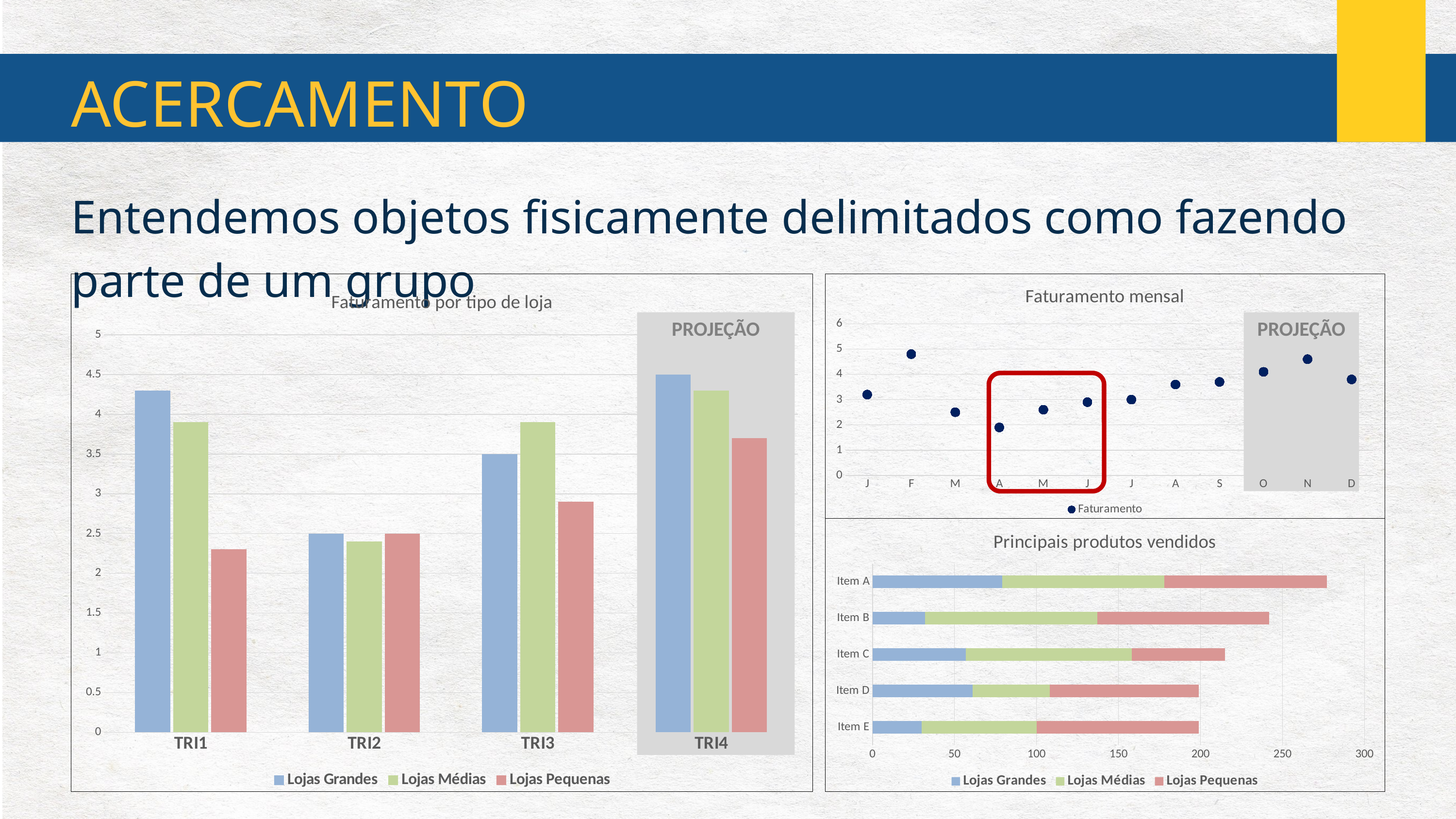
In the 'Principais produtos vendidos' chart, is the total for Item E greater or less than 250? less In the 'Faturamento mensal' chart, how many data points are plotted? 12 In the 'Faturamento mensal' chart, is the value for F greater or less than 4? greater In the 'Faturamento por tipo de loja' chart, which quarter has the lowest value for Lojas Grandes? TRI2 In the 'Faturamento por tipo de loja' chart, how many series does the legend list? 3 What kind of chart is 'Faturamento por tipo de loja'? bar chart In the 'Faturamento por tipo de loja' chart, is the value for Lojas Grandes in TRI1 greater or less than 4? greater In the 'Principais produtos vendidos' chart, which item has the longest total bar? Item A In the 'Faturamento mensal' chart, which month has the lowest value? A (April) In the 'Faturamento por tipo de loja' chart, how many quarters are shown on the x axis? 4 In the 'Faturamento por tipo de loja' chart, in TRI1, which is larger: Lojas Grandes or Lojas Pequenas? Lojas Grandes In the 'Principais produtos vendidos' chart, how many items are listed on the vertical axis? 5